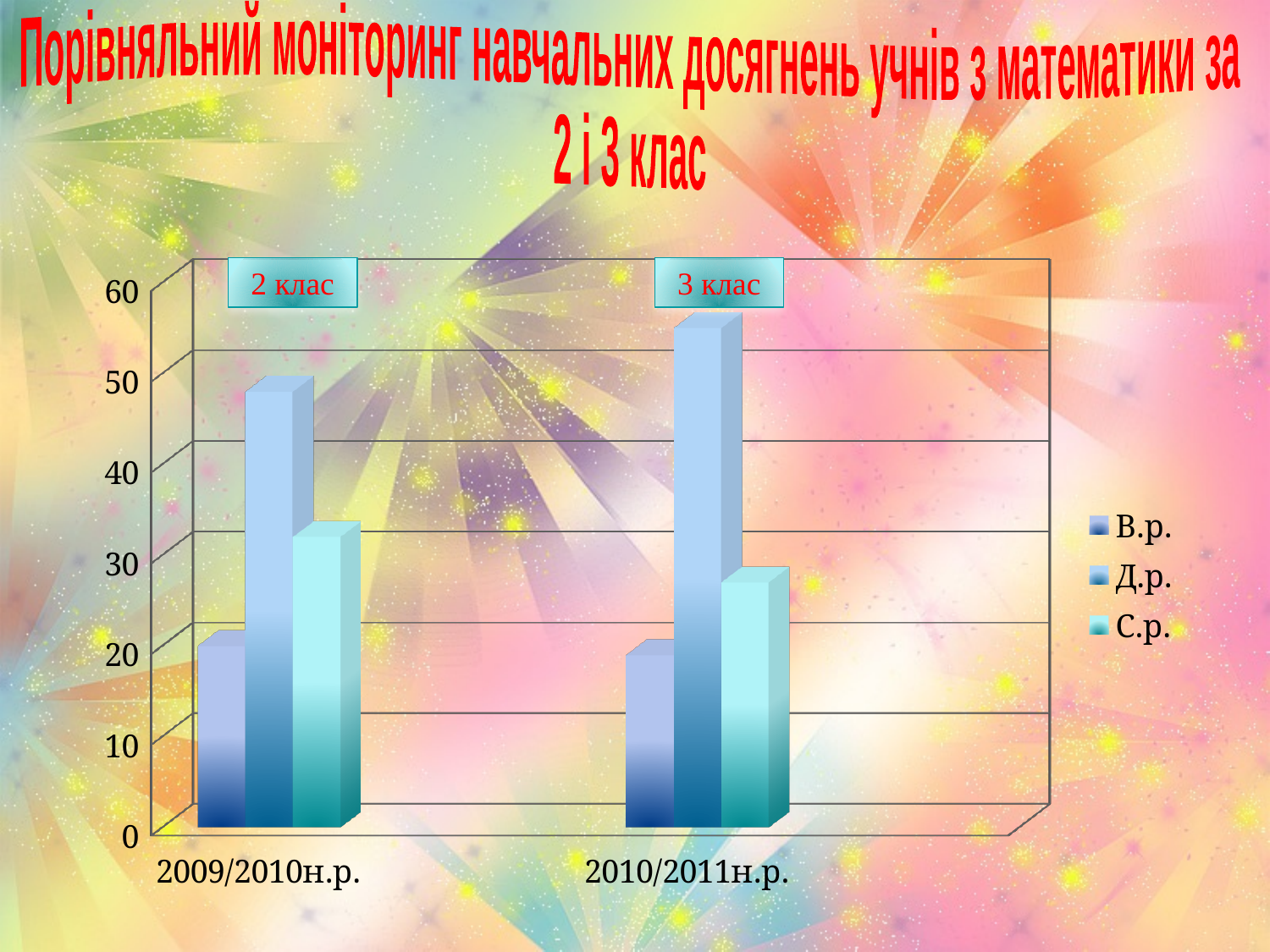
What are the three entries listed in the legend? В.р., Д.р., С.р. How many series does the legend list? 3 Is the value for С.р. in 2010/2011н.р. greater or less than 40? less Is the value for В.р. in 2009/2010н.р. greater or less than 30? less What kind of chart is shown on the slide? bar chart Which series has the highest bar in the 2009/2010н.р. category? Д.р. Which is larger: Д.р. in 2009/2010н.р. or Д.р. in 2010/2011н.р.? 2010/2011н.р. Is the value for Д.р. in 2010/2011н.р. greater or less than 50? greater Which is larger: С.р. in 2009/2010н.р. or С.р. in 2010/2011н.р.? 2009/2010н.р. Which series has the lowest bar in the 2010/2011н.р. category? В.р. How many categories are shown on the x axis? 2